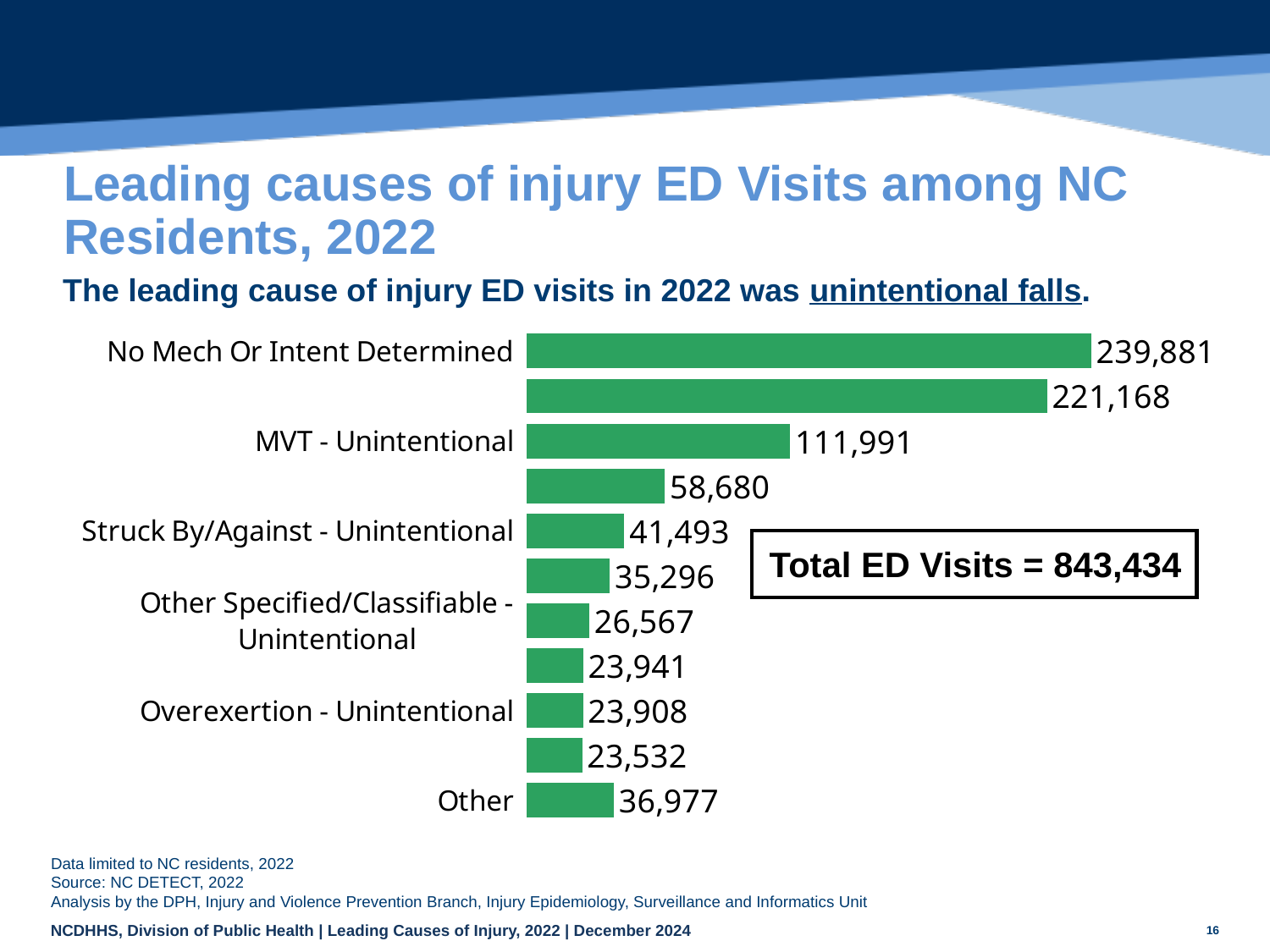
What is the value for Other Specified/Classifiable - Unintentional? 26,567 What is the difference between the values for No Mech Or Intent Determined and MVT - Unintentional? 127,890 What kind of chart is shown on the slide? Bar chart What is the value for MVT - Unintentional? 111,991 What total number of ED visits is stated in the box on the chart? 843,434 How many bars are shown in the chart? 11 What is the value for Struck By/Against - Unintentional? 41,493 Which is larger, the value for Other or the value for Overexertion - Unintentional? Other What is the value for Other? 36,977 What is the value for No Mech Or Intent Determined? 239,881 What is the value for Overexertion - Unintentional? 23,908 Which category has the highest value? No Mech Or Intent Determined